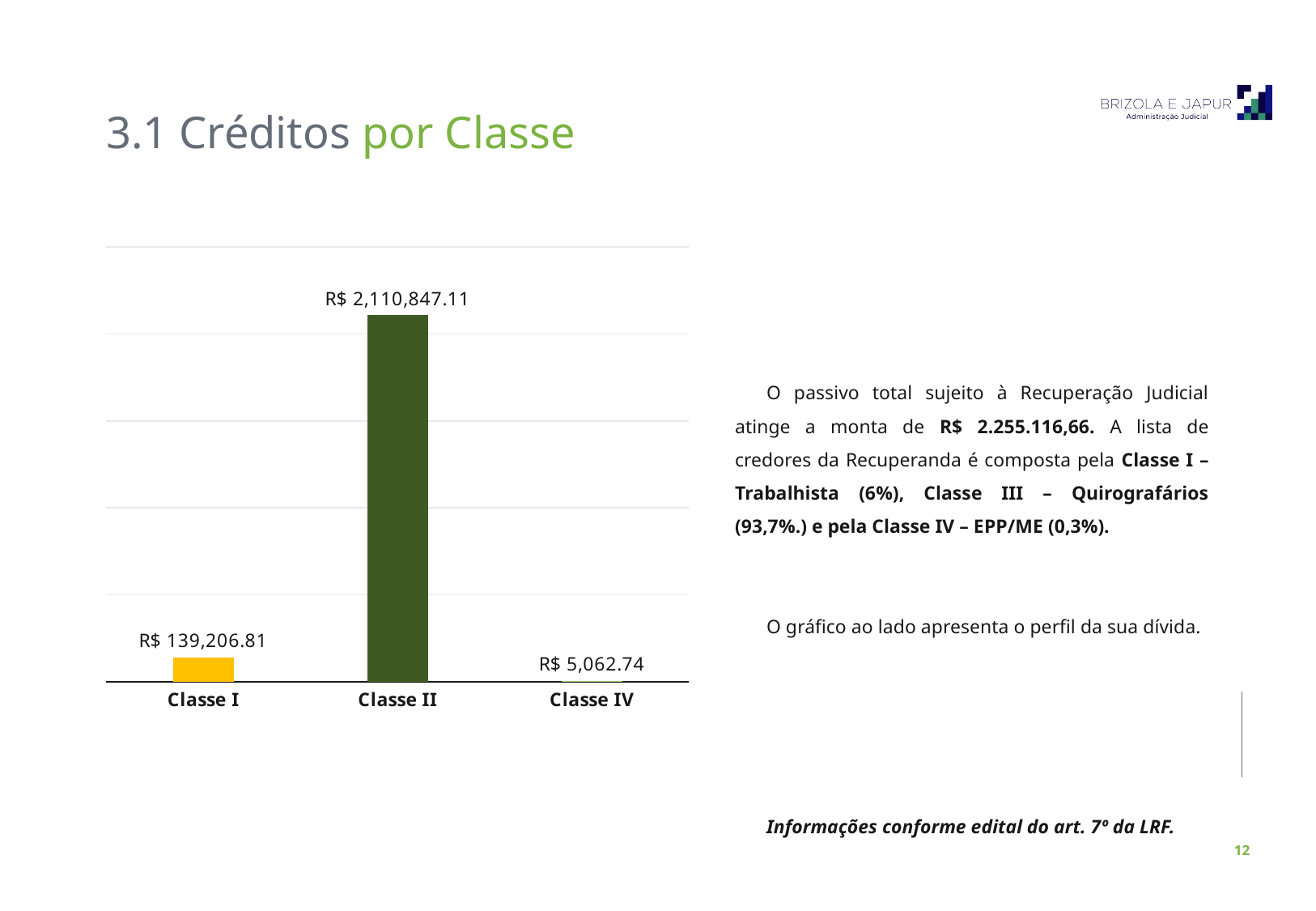
What is the value shown for Classe IV? R$ 5,062.74 What is the value shown for Classe I? R$ 139,206.81 What is the value shown for Classe II? R$ 2,110,847.11 What is the difference between the values for Classe II and Classe I? R$ 1,971,640.30 What kind of chart is shown on the slide? Bar chart How many classes are shown on the x axis of the chart? 3 Which is larger, the value for Classe I or the value for Classe IV? Classe I Which class has the lowest value in the chart? Classe IV What colour is the bar for Classe I? Yellow Which class has the highest value in the chart? Classe II What is the difference between the values for Classe I and Classe IV? R$ 134,144.07 Which is larger, the value for Classe II or the value for Classe I? Classe II